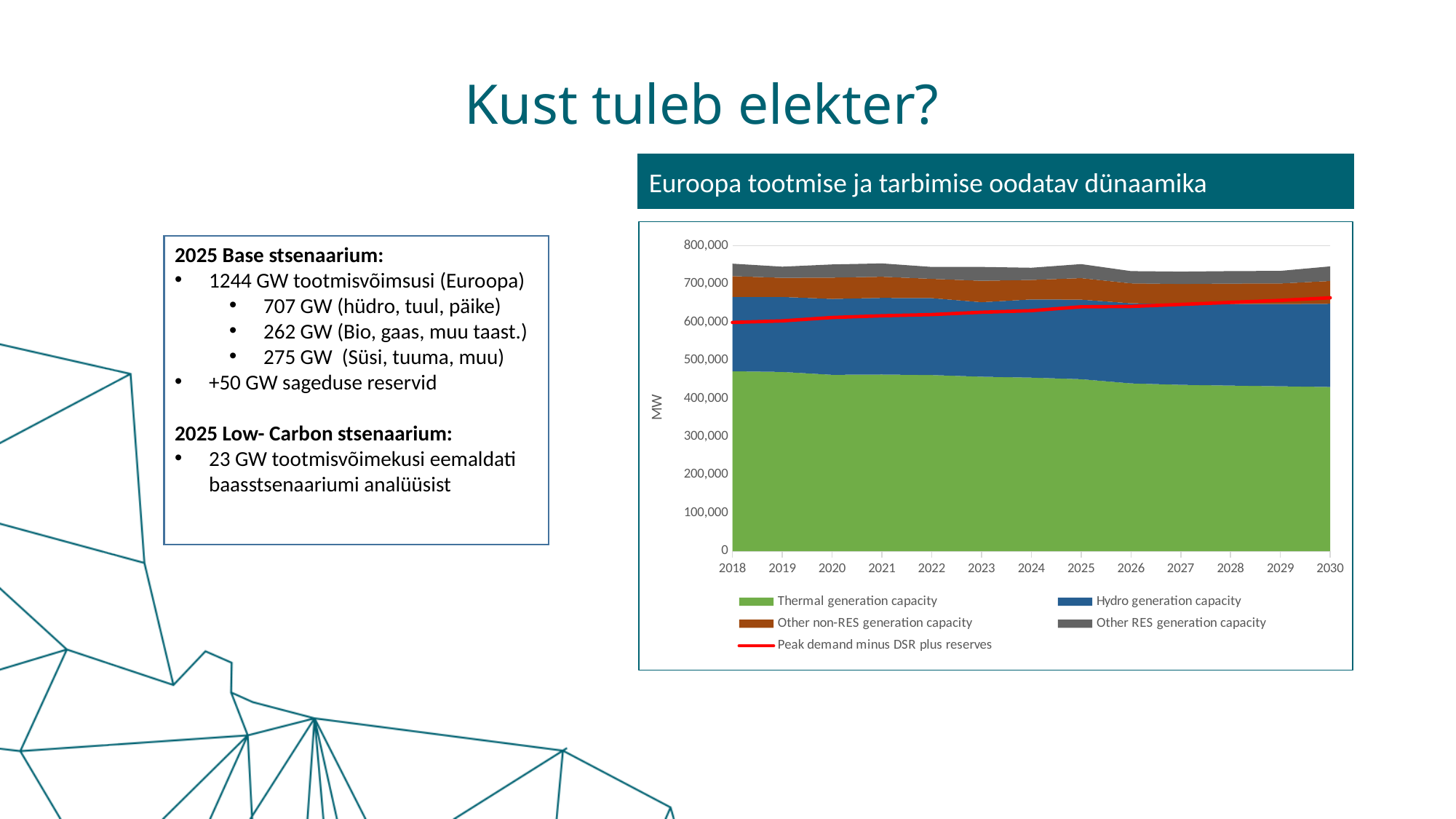
What is the first year shown on the x axis of the chart? 2018 What unit is shown on the y axis of the chart? MW Is the Thermal generation capacity in 2018 greater or less than 400,000? greater Does the Thermal generation capacity area rise or fall from 2018 to 2030? Fall Is the Thermal generation capacity in 2030 greater or less than 500,000? less Is the 'Peak demand minus DSR plus reserves' value in 2030 greater or less than 600,000? greater Does the 'Peak demand minus DSR plus reserves' line rise or fall from 2018 to 2030? Rise How many years are shown along the x axis of the chart? 13 Which series occupies the largest area in the chart? Thermal generation capacity What kind of chart is shown under the title 'Euroopa tootmise ja tarbimise oodatav dünaamika'? Stacked area chart with a line How many series does the legend of the chart list? 5 What is the last year shown on the x axis of the chart? 2030